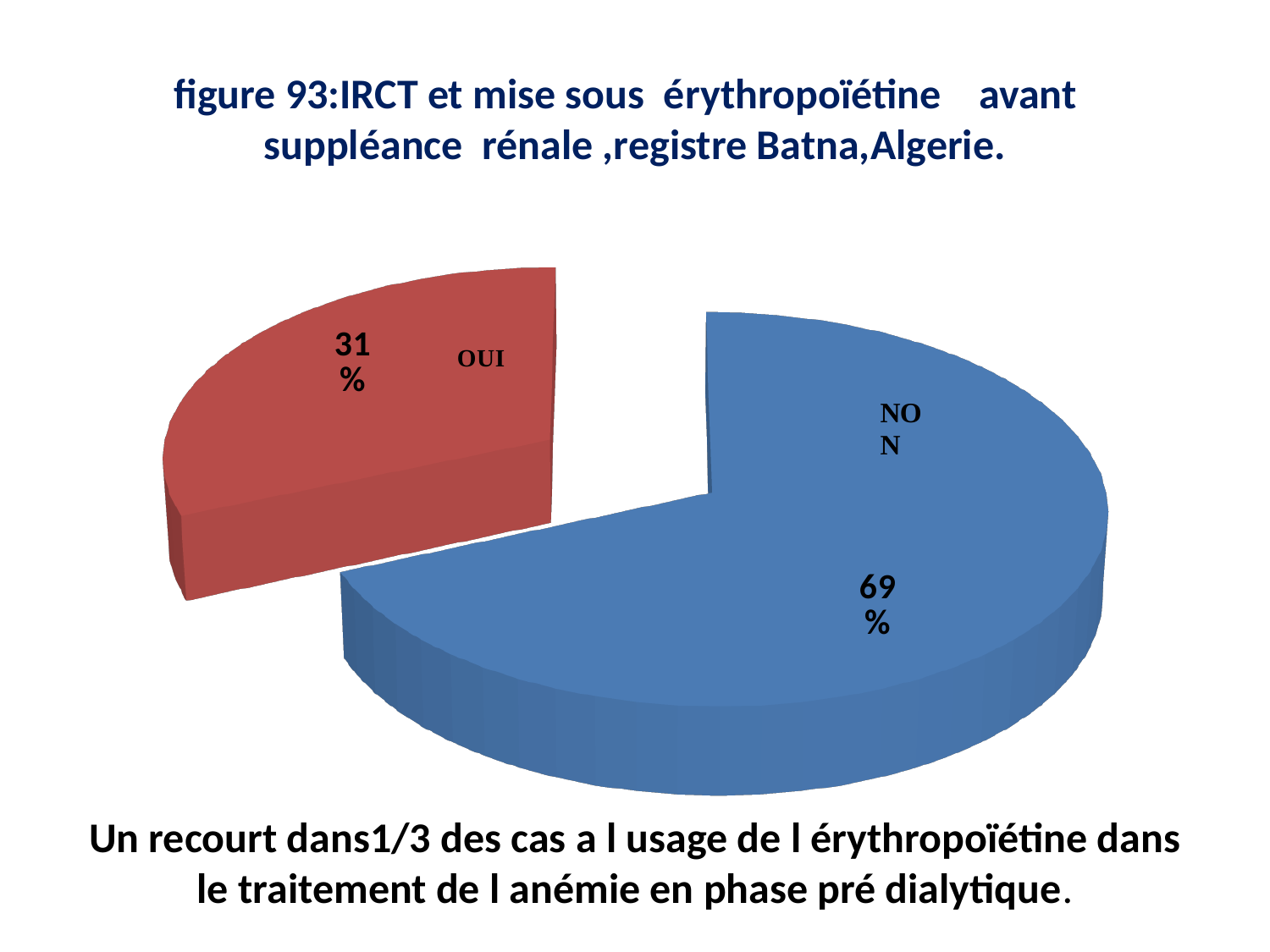
Which slice of the pie chart is the largest? NON What percentage of the pie chart is labelled OUI? 31% What colour is the NON slice of the pie chart? Blue How many slices does the pie chart have? 2 What is the difference in percentage points between the NON slice and the OUI slice? 38 What percentage of the pie chart is labelled NON? 69% Which slice of the pie chart is the smallest? OUI Which slice is larger, OUI or NON? NON What kind of chart is shown on the slide? Pie chart What share of the pie does the OUI slice represent? 31% What colour is the OUI slice of the pie chart? Red